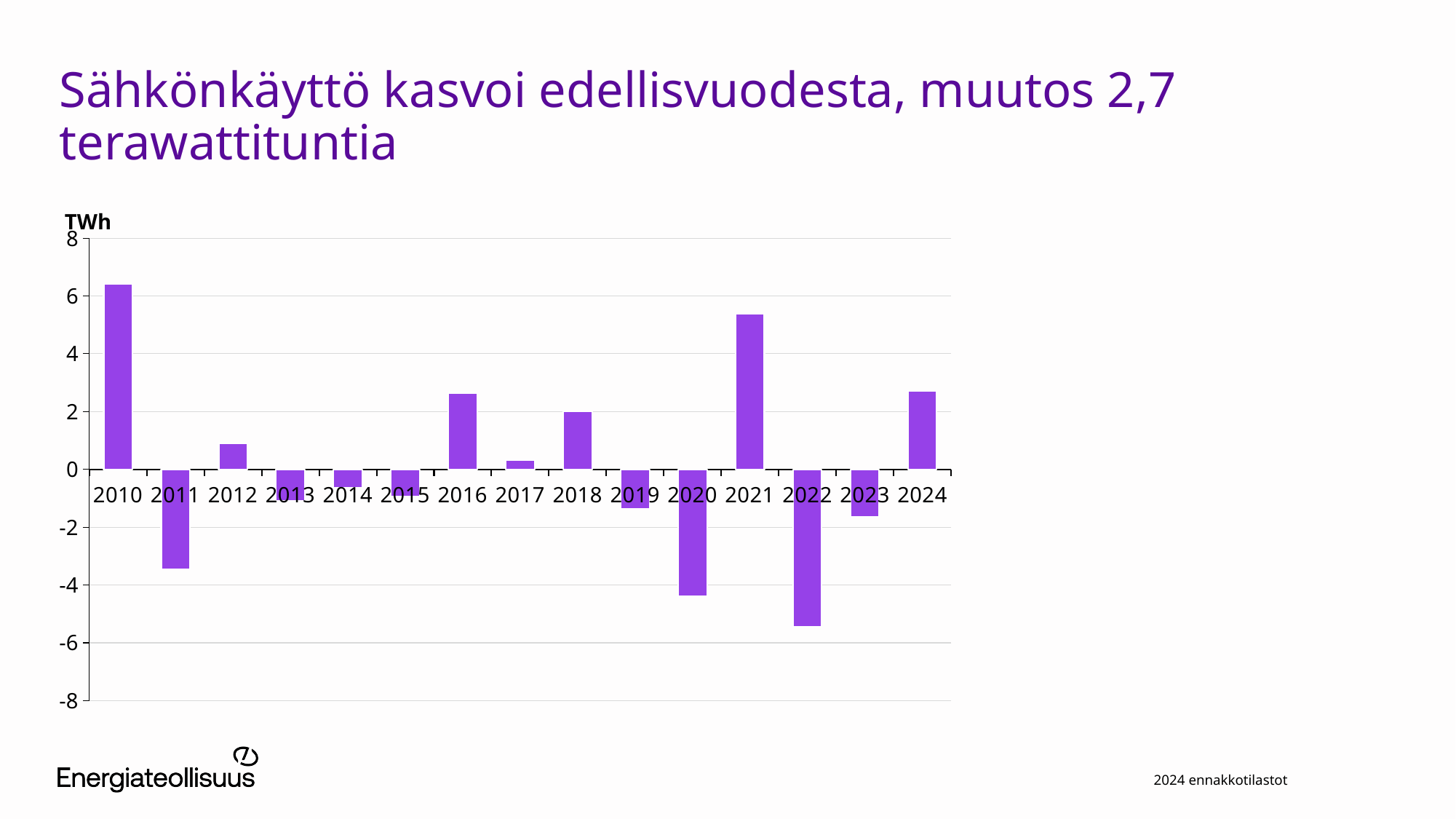
What kind of chart is shown on the slide? bar chart How many years are shown on the x axis of the chart? 15 Is the value for 2022 less or greater than -4? less According to the slide title, what is the change in electricity use for 2024 in terawatt-hours? 2,7 What unit is shown on the vertical axis of the chart? TWh Is the value for 2021 greater or less than 4? greater Which is larger, the value for 2016 or the value for 2018? 2016 Is the value for 2010 greater or less than 6? greater Which is larger, the value for 2010 or the value for 2021? 2010 Which year has the lowest value in the chart? 2022 Which year has the highest value in the chart? 2010